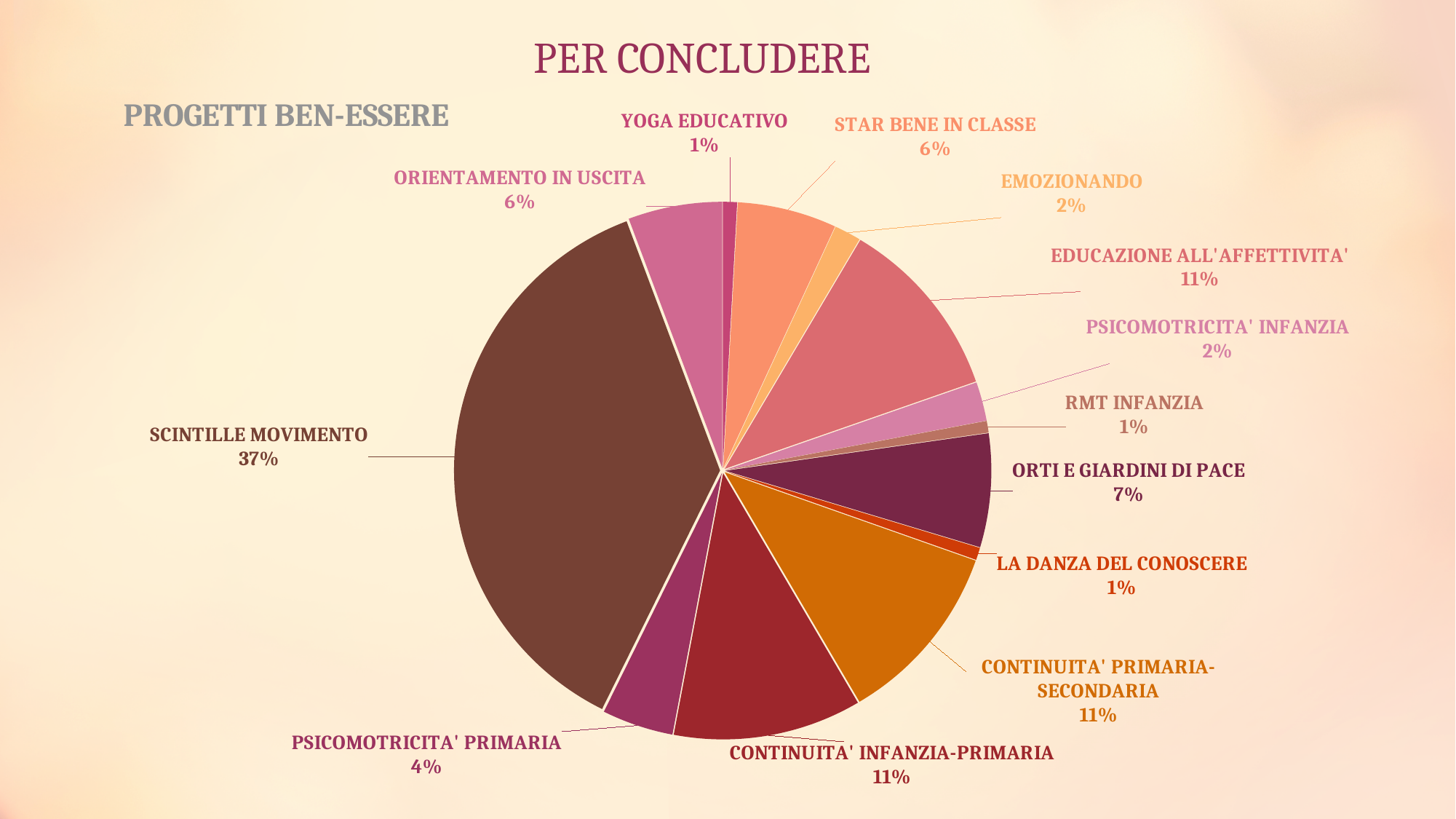
Which is larger, ORTI E GIARDINI DI PACE or EMOZIONANDO? ORTI E GIARDINI DI PACE Which category has the largest slice of the pie? SCINTILLE MOVIMENTO What is the difference in percentage points between SCINTILLE MOVIMENTO and ORTI E GIARDINI DI PACE? 30 What is the value for ORTI E GIARDINI DI PACE? 7% What is the chart's title? PROGETTI BEN-ESSERE What is the value for EDUCAZIONE ALL'AFFETTIVITA'? 11% What kind of chart is shown on the slide? pie chart How many slices does the pie chart have? 13 What is the value for PSICOMOTRICITA' PRIMARIA? 4% What share of the pie does SCINTILLE MOVIMENTO take? 37% What is the value for STAR BENE IN CLASSE? 6% What is the value for RMT INFANZIA? 1%